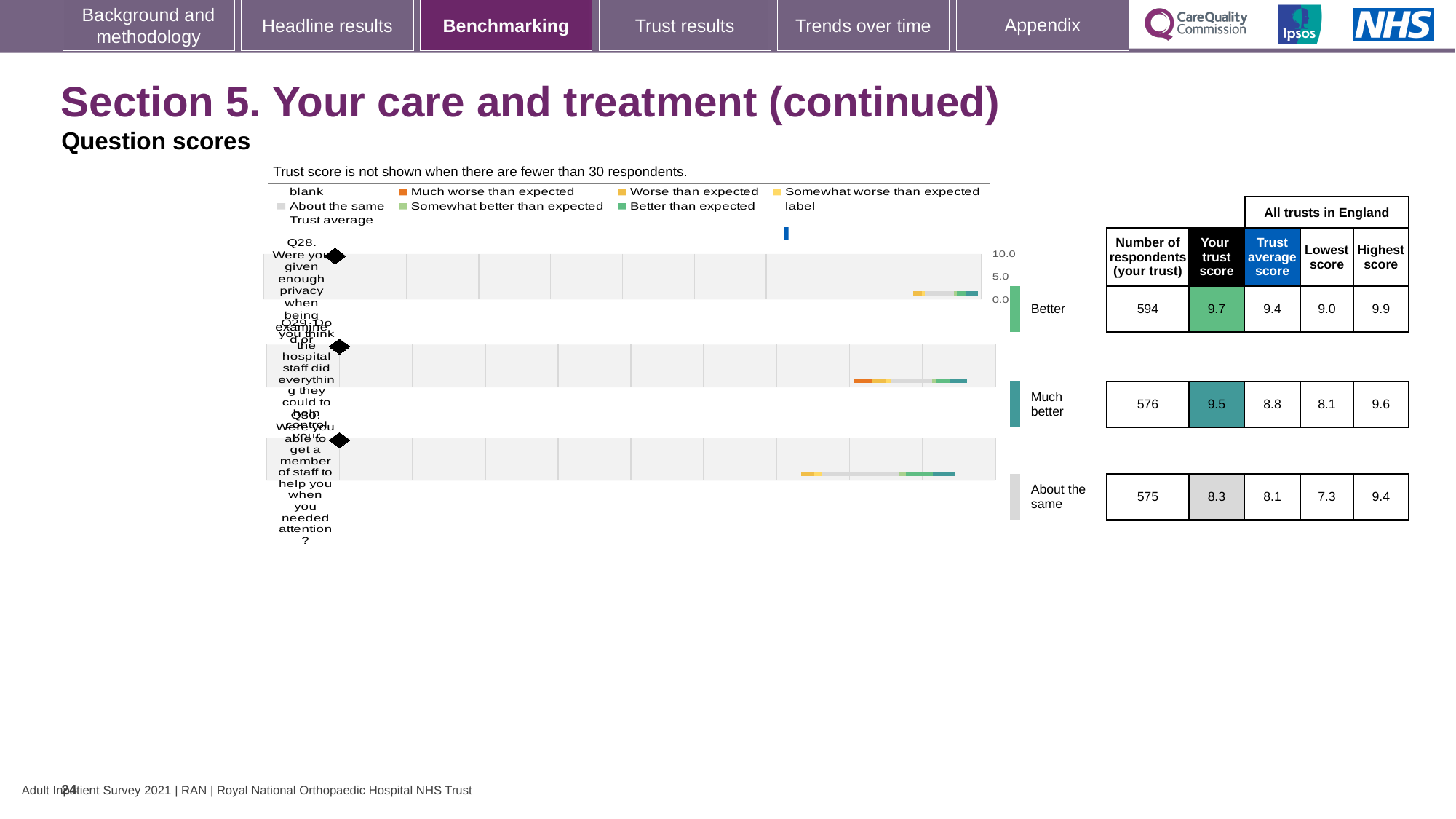
What is the trust score for Q28 (privacy when being examined or treated)? 9.7 Which question has the highest trust score? Q28 What is the trust score for Q29 (hospital staff did everything they could to help control pain)? 9.5 How many questions are plotted on the chart? 3 For Q29, which is larger: the trust score or the trust average score? The trust score (9.5) What kind of chart is shown on the slide? Bar chart What is the trust score for Q30 (able to get a member of staff to help when needed attention)? 8.3 What is the trust average score for Q30? 8.1 What is the difference between the trust score and the trust average score for Q28? 0.3 Which benchmark category is Q29 placed in? Much better How many respondents answered Q29 at this trust? 576 Which question has the lowest trust score? Q30